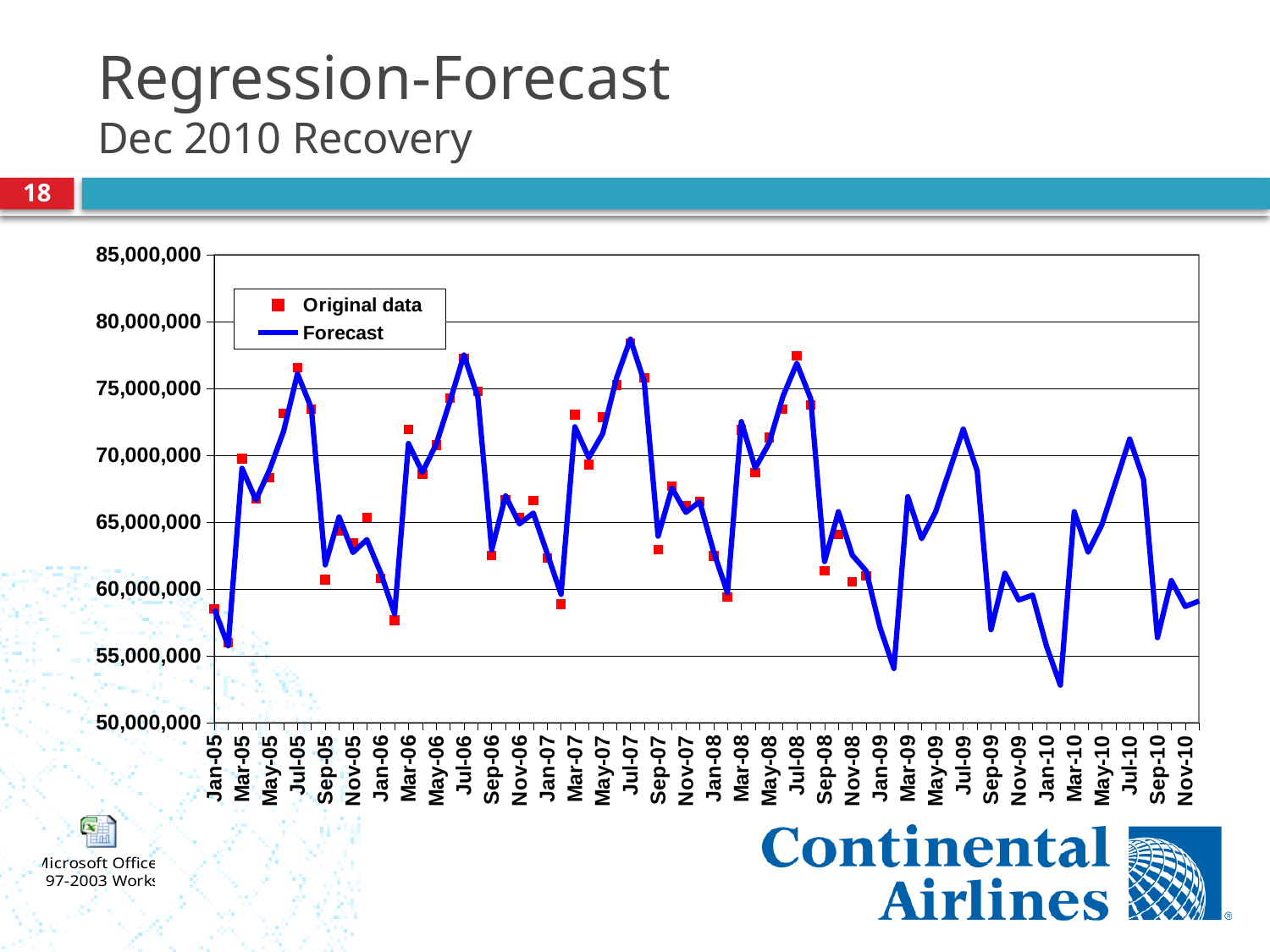
Is the Forecast value for Jul-09 greater or less than 70,000,000? greater Is the Original data value for Sep-05 greater or less than 65,000,000? less Is the Forecast value for Jul-07 greater or less than 75,000,000? greater Does the Forecast line rise or fall from Jul-08 to Jan-09? fall What are the two series named in the legend? Original data and Forecast What kind of chart is shown on the slide? line chart How many series does the legend list? 2 Which series is drawn as red square markers? Original data Which is larger, the Forecast value for Jul-07 or for Jul-09? Jul-07